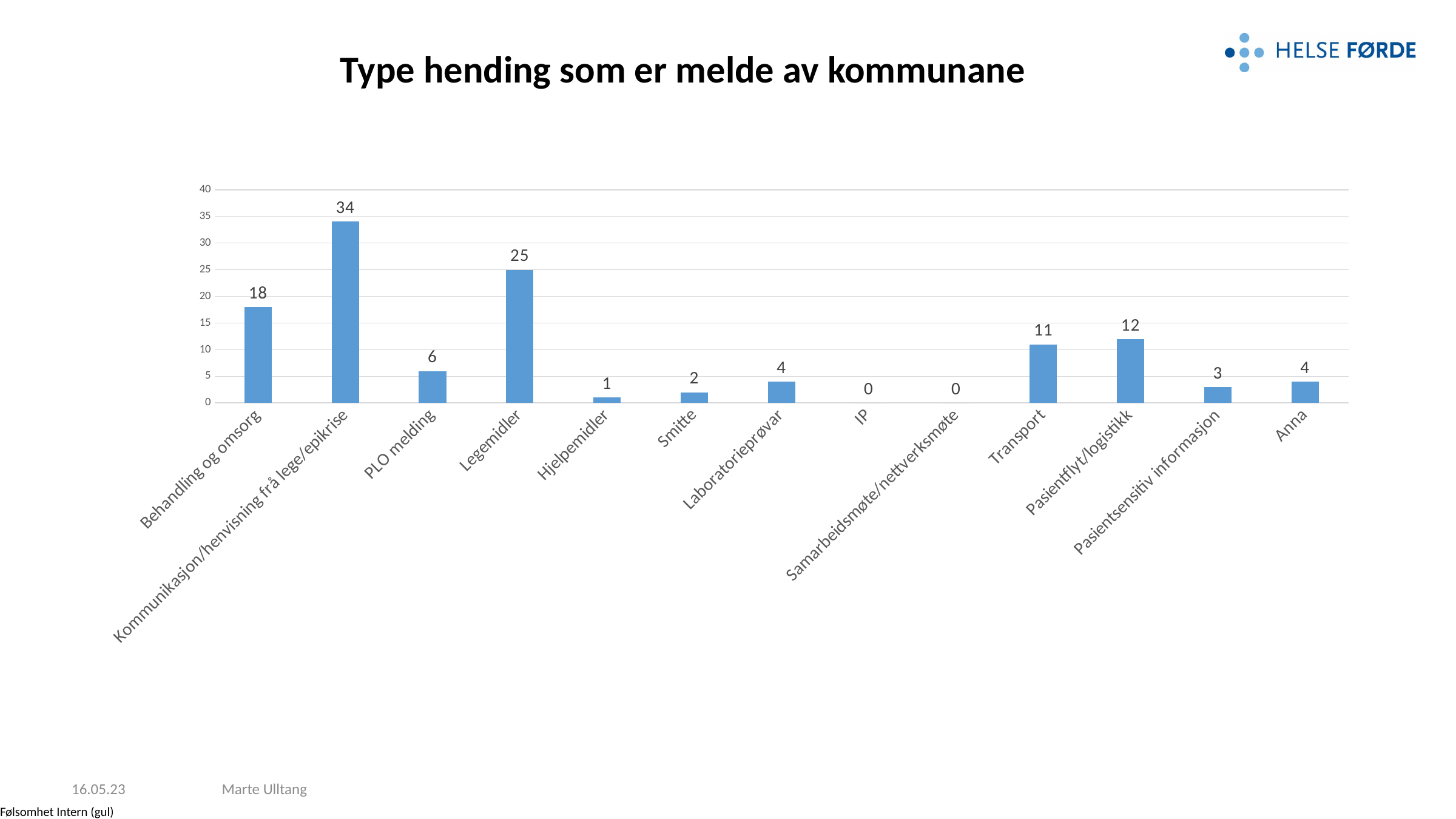
What is the title of the chart? Type hending som er melde av kommunane What is the difference between the values for Behandling og omsorg and Transport? 7 What is the difference between the values for Kommunikasjon/henvisning frå lege/epikrise and Legemidler? 9 Which is larger, the value for Transport or the value for Pasientflyt/logistikk? Pasientflyt/logistikk What is the value for Pasientflyt/logistikk? 12 What is the value for Pasientsensitiv informasjon? 3 What kind of chart is shown on the slide? bar chart Which category has the highest value? Kommunikasjon/henvisning frå lege/epikrise Is the value for Legemidler greater or less than 20? greater What is the value for Behandling og omsorg? 18 What is the value for Legemidler? 25 How many categories are shown on the x axis? 13